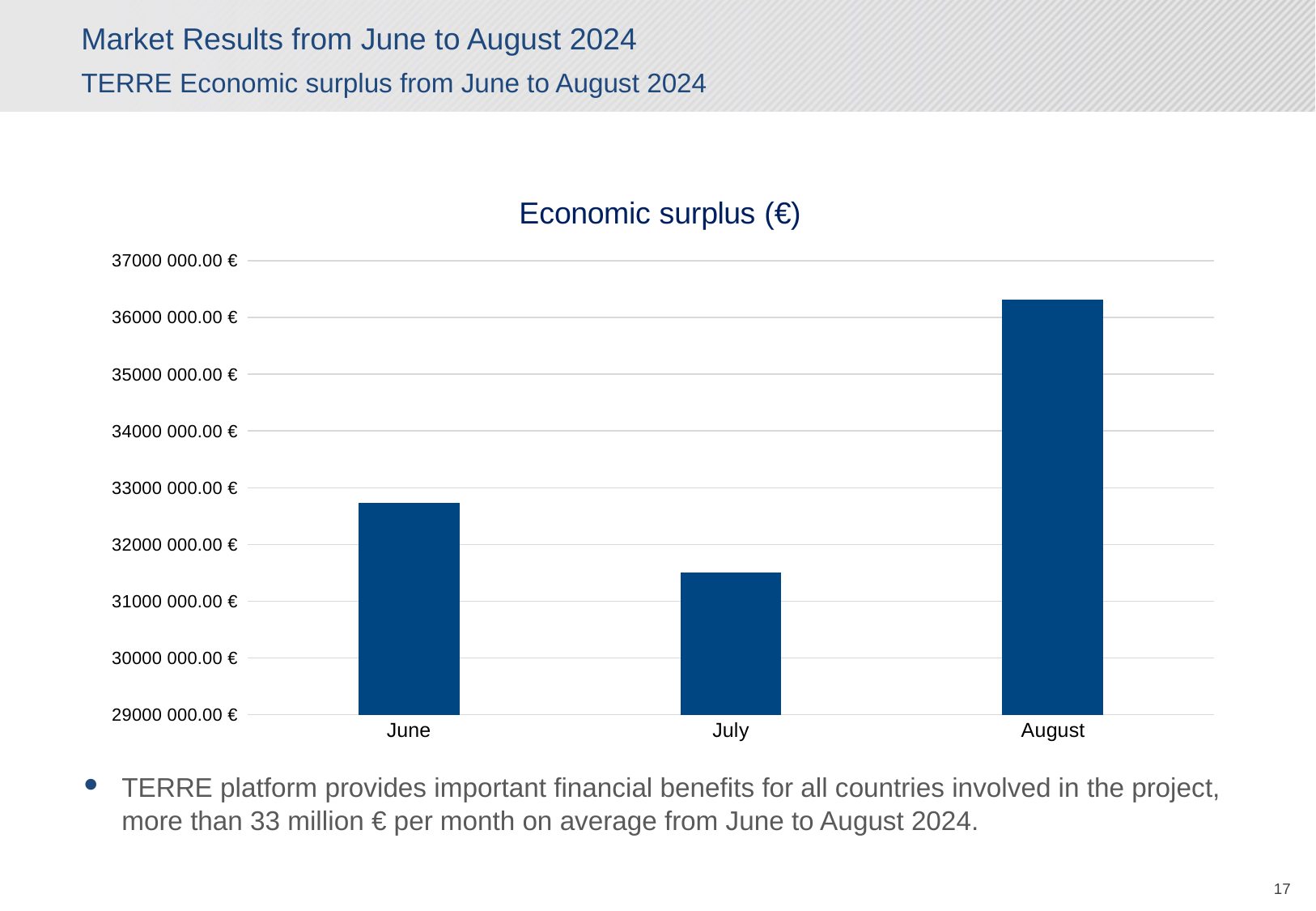
Is the economic surplus for August greater or less than 36000 000.00 €? greater Which month has the lowest economic surplus? July Which month has the larger economic surplus, June or July? June Which month has the larger economic surplus, June or August? August What is the lowest value shown on the vertical axis of the chart? 29000 000.00 € Is the economic surplus for July greater or less than 31000 000.00 €? greater What is the title of the chart? Economic surplus (€) Is the economic surplus for June greater or less than 32000 000.00 €? greater How many months are plotted in the Economic surplus chart? 3 What kind of chart is shown on the slide? bar chart Which month has the highest economic surplus? August